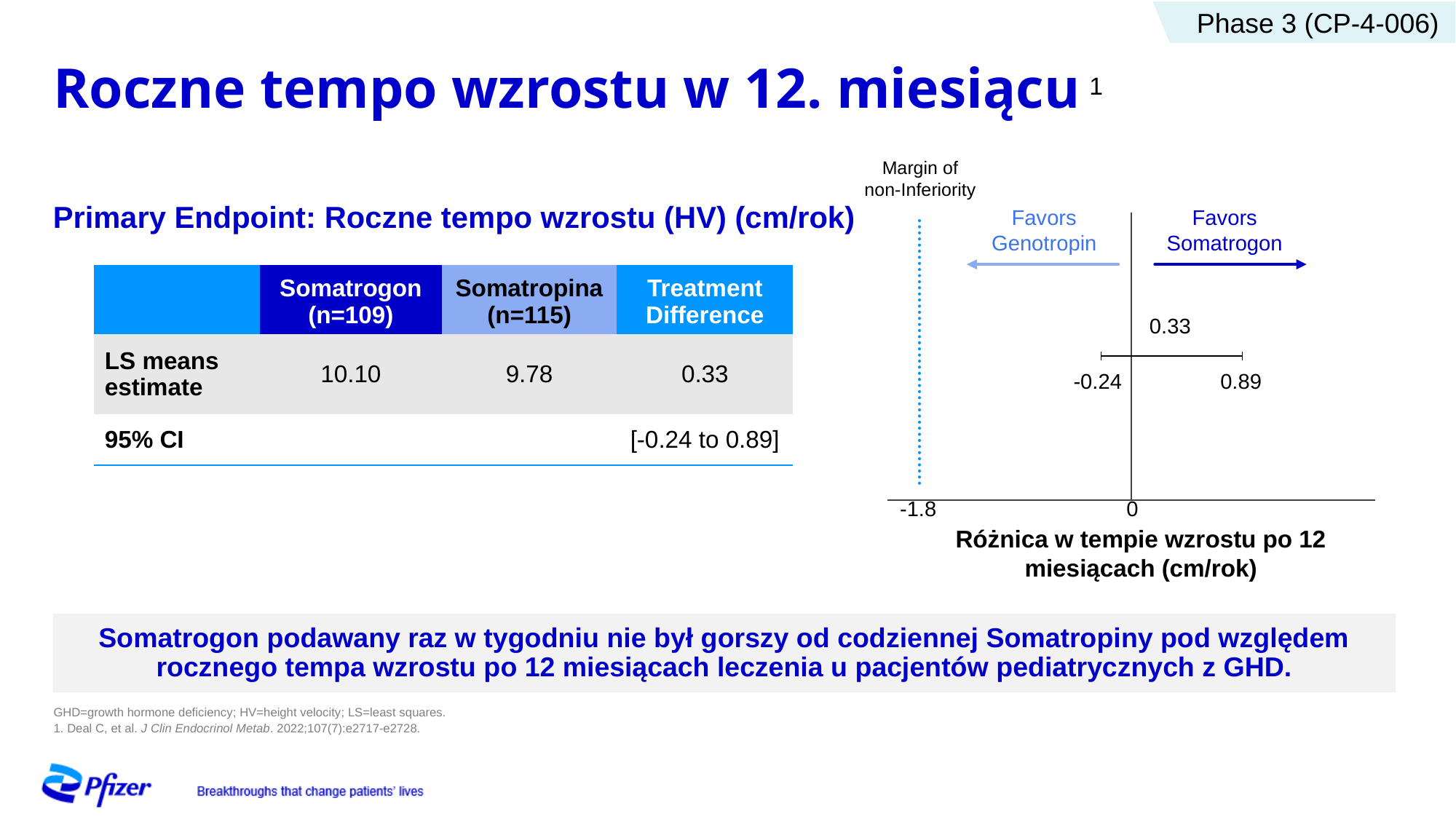
What kind of chart is shown on the right of the slide? forest plot How many point estimates are plotted on the chart? 1 Is the lower confidence bound of -0.24 greater or less than the non-inferiority margin of -1.8 on the chart? greater On the chart, which treatment is favored by values to the right of the vertical line at 0? Somatrogon Is the plotted point estimate of 0.33 greater or less than 0 on the chart's x axis? greater On the chart, at what value on the x axis is the margin of non-inferiority (dotted line) placed? -1.8 What is the x-axis title of the chart? Różnica w tempie wzrostu po 12 miesiącach (cm/rok) On the chart, what is the plotted point estimate for the difference in height velocity at 12 months? 0.33 On the chart, what is the width of the confidence interval, i.e. the difference between 0.89 and -0.24? 1.13 On the chart, which is larger: the upper confidence bound (0.89) or the point estimate (0.33)? 0.89 On the chart, what is the lower bound of the confidence interval shown around the point estimate? -0.24 On the chart, what is the upper bound of the confidence interval shown around the point estimate? 0.89